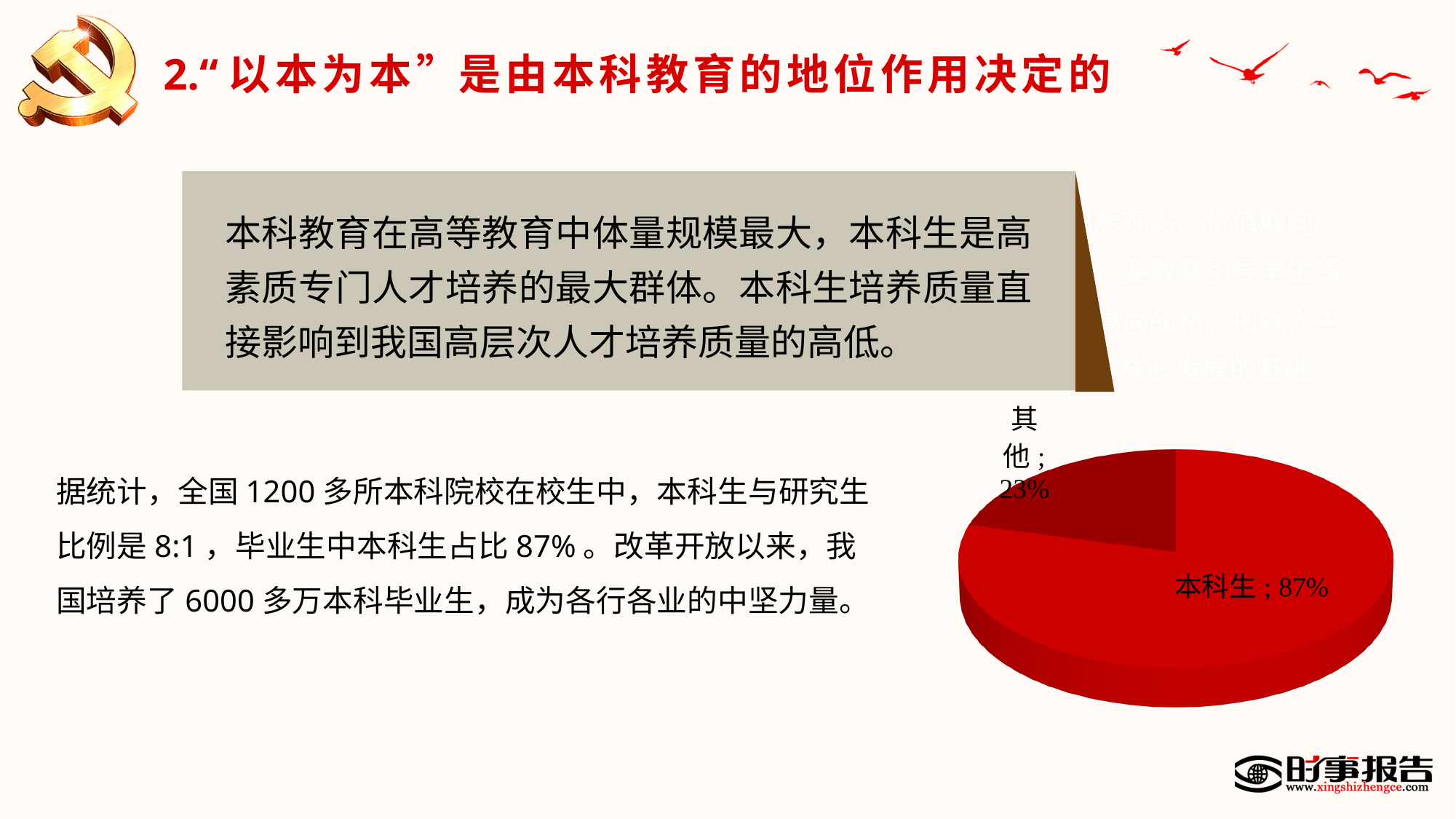
Which slice of the pie chart is the largest? 本科生 What share of the pie does the 本科生 slice represent? 87% What colour is the 本科生 slice in the pie chart? red Which is larger in the pie chart, 本科生 or 其他? 本科生 Which slice of the pie chart is the smallest? 其他 What percentage is shown for 本科生 in the pie chart? 87% How many slices does the pie chart have? 2 What percentage is shown for 其他 in the pie chart? 23% What is the difference between the percentages shown for 本科生 and 其他 in the pie chart? 64% What kind of chart is shown on the slide? pie chart